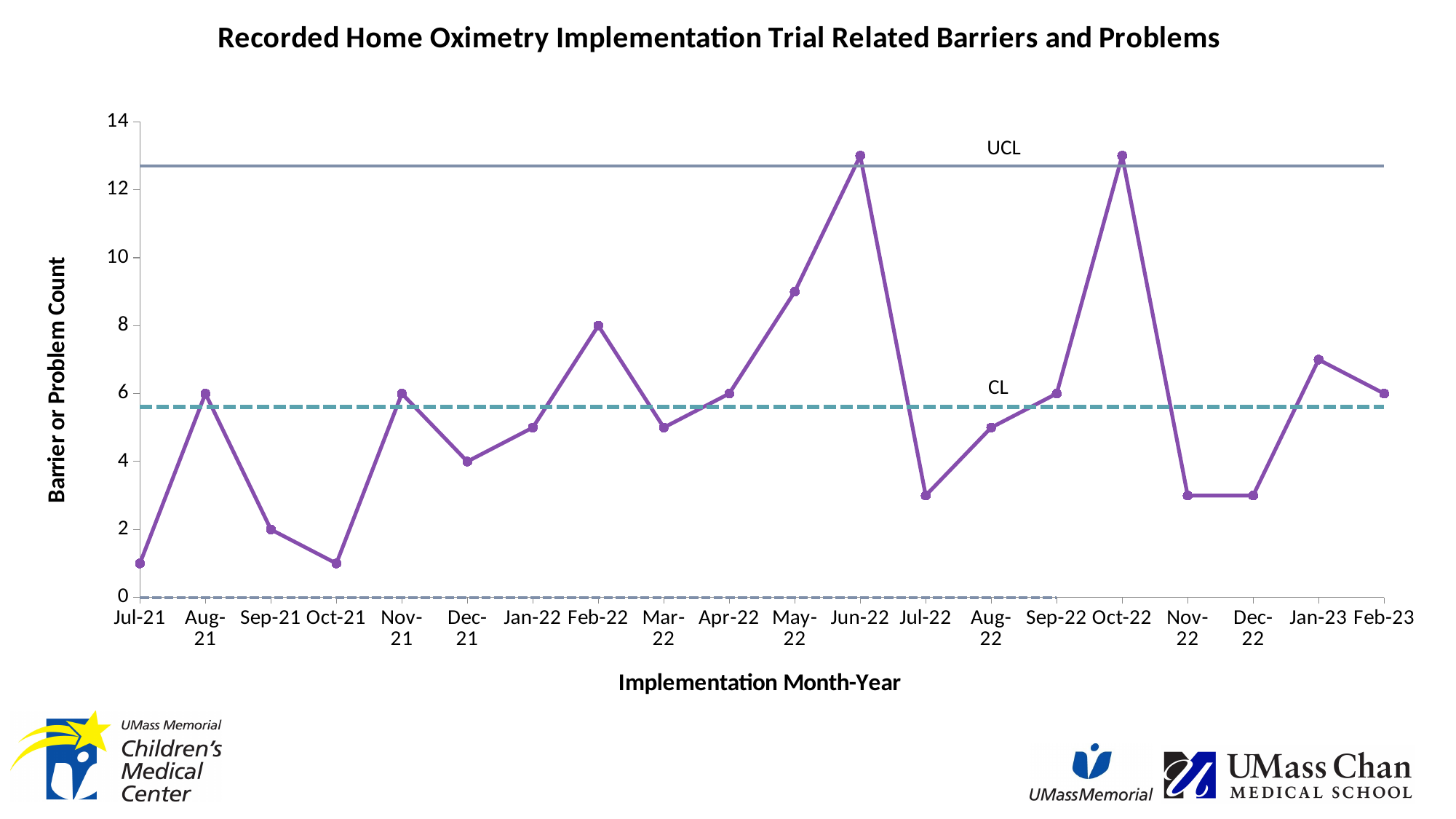
What is the Barrier or Problem Count for Feb-23? 6 Which has a higher Barrier or Problem Count, Feb-22 or Apr-22? Feb-22 What is the title of the y axis? Barrier or Problem Count What is the Barrier or Problem Count for Dec-21? 4 How many months are plotted on the x axis? 20 What is the Barrier or Problem Count for Feb-22? 8 What is the difference between the values for Feb-22 and Dec-21? 4 Is the value for Jul-22 greater or less than 4? less What is the Barrier or Problem Count for Sep-21? 2 What type of chart is shown on the slide? Line chart Is the value for Jul-21 greater or less than 2? less Is the value for Jun-22 greater or less than 12? greater